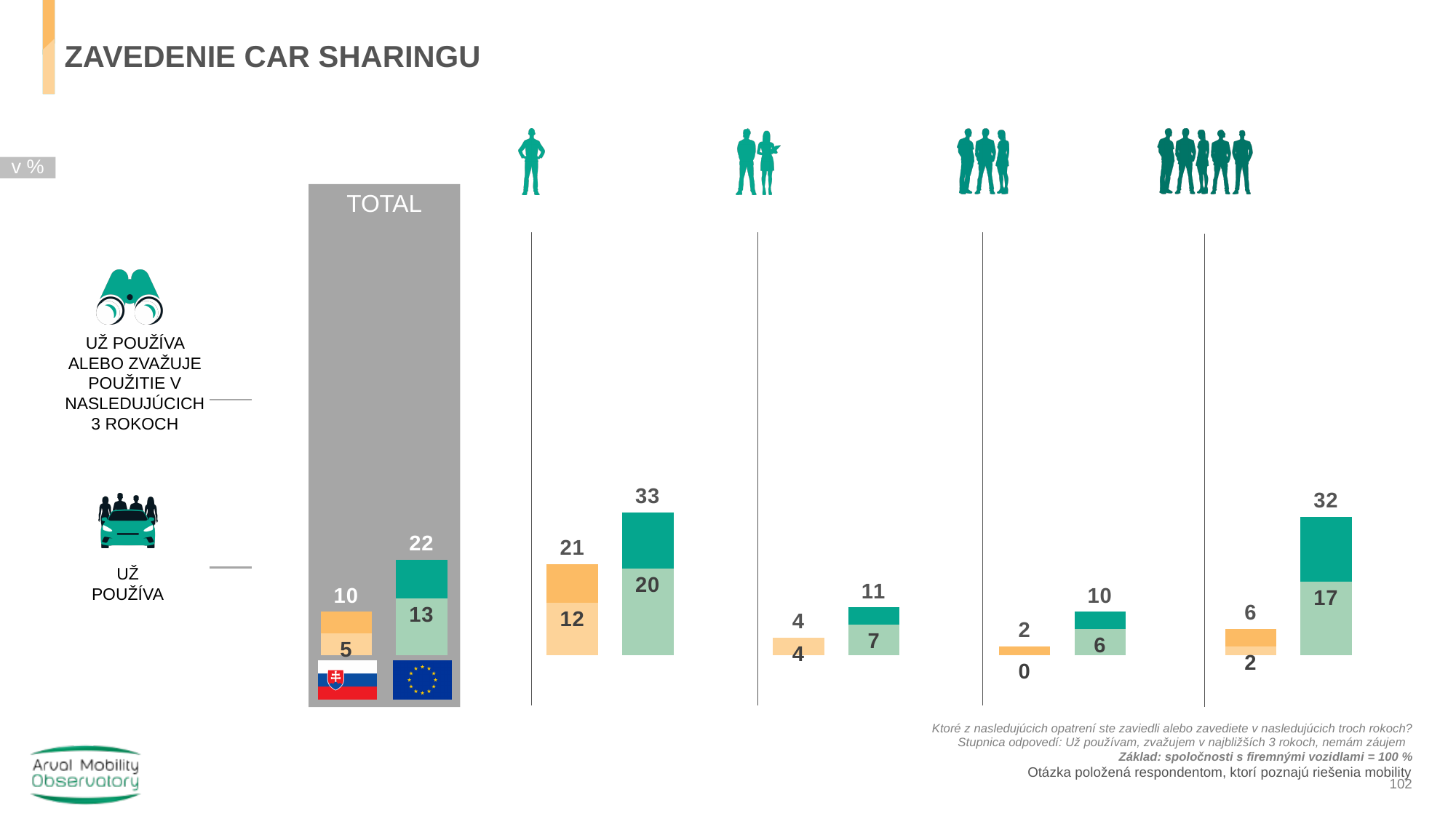
In the TOTAL column, what is the value printed above the Slovakia (orange) bar for 'už používa alebo zvažuje použitie v nasledujúcich 3 rokoch'? 10 What type of chart is shown on the slide? Bar chart In the TOTAL column, what is the 'už používa' value for the EU (green) bar? 13 Which group has the lowest Slovakia (orange) 'už používa' value? The third group (three-person icon), 0 Which group has the highest EU (green) value for 'už používa alebo zvažuje použitie v nasledujúcich 3 rokoch'? The first group (single-person icon), 33 In the first group to the right of the TOTAL column (single-person icon), what is the value above the Slovakia (orange) bar? 21 In the rightmost group (five-person icon), what is the difference between the EU value (32) and the Slovakia value (6) above the bars? 26 What unit is indicated for the values on the chart? v % In the second group (two-person icon), which is larger: the EU value above the bar or the Slovakia value above the bar? EU (11) In the first group to the right of the TOTAL column (single-person icon), what is the 'už používa' value for the EU (green) bar? 20 In the TOTAL column, what is the value printed above the EU (green) bar? 22 What is the title of the chart on the slide? ZAVEDENIE CAR SHARINGU